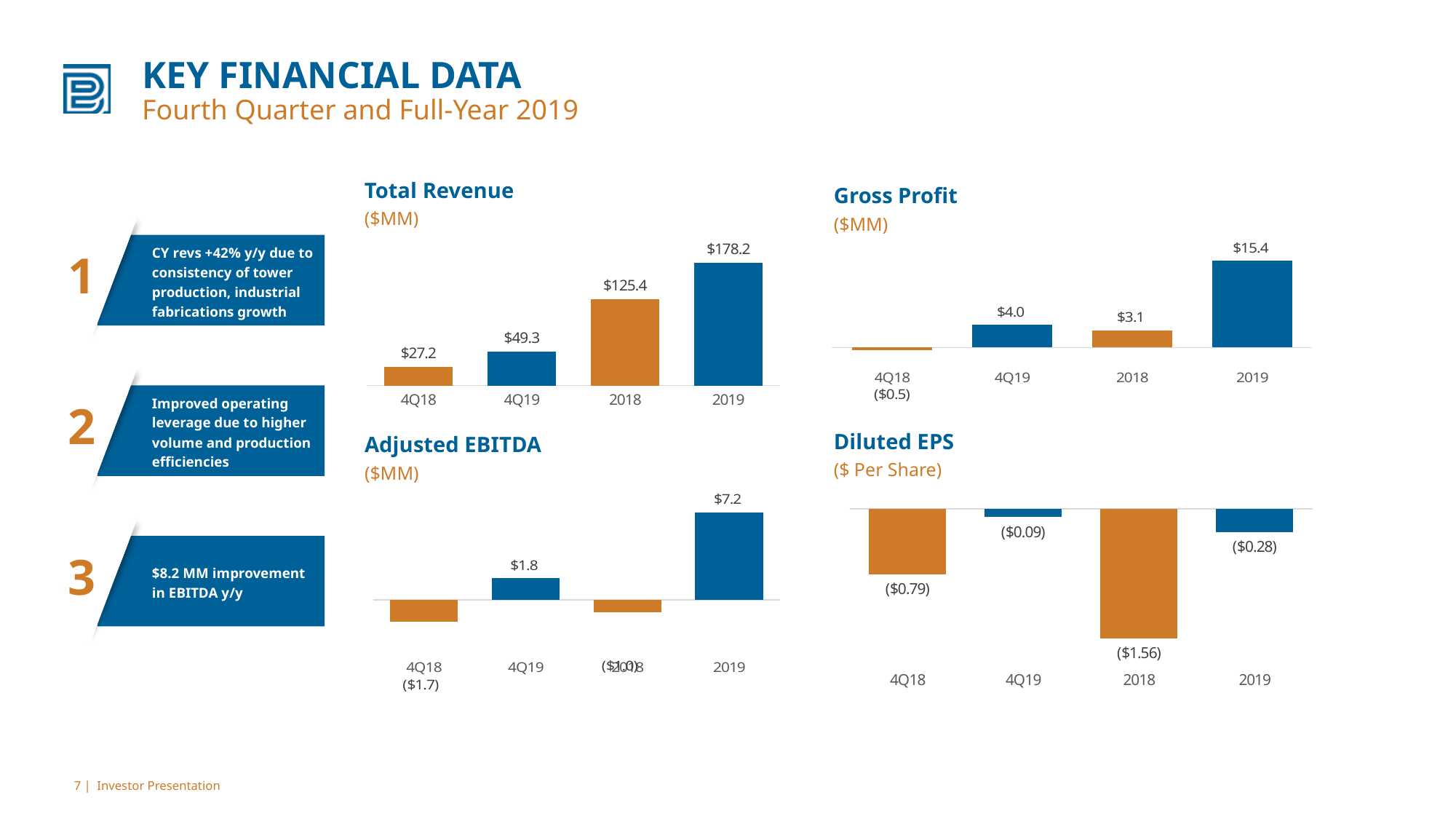
In the Diluted EPS chart, which category has the lowest value? 2018 In the Gross Profit chart, which category has the highest value? 2019 In the Adjusted EBITDA chart, what is the value for 2019? $7.2 In the Diluted EPS chart, what is the value for 4Q19? ($0.09) In the Gross Profit chart, what is the value for 4Q18? ($0.5) In the Total Revenue chart, what is the value for 2019? $178.2 In the Total Revenue chart, what is the difference between the 2019 and 2018 values? $52.8 What type of chart is the Total Revenue chart? Bar chart In the Gross Profit chart, which is larger, the value for 4Q19 or the value for 2018? 4Q19 In the Total Revenue chart, what is the value for 4Q19? $49.3 How many categories are shown in the Diluted EPS chart? 4 In the Adjusted EBITDA chart, what is the value for 4Q18? ($1.7)